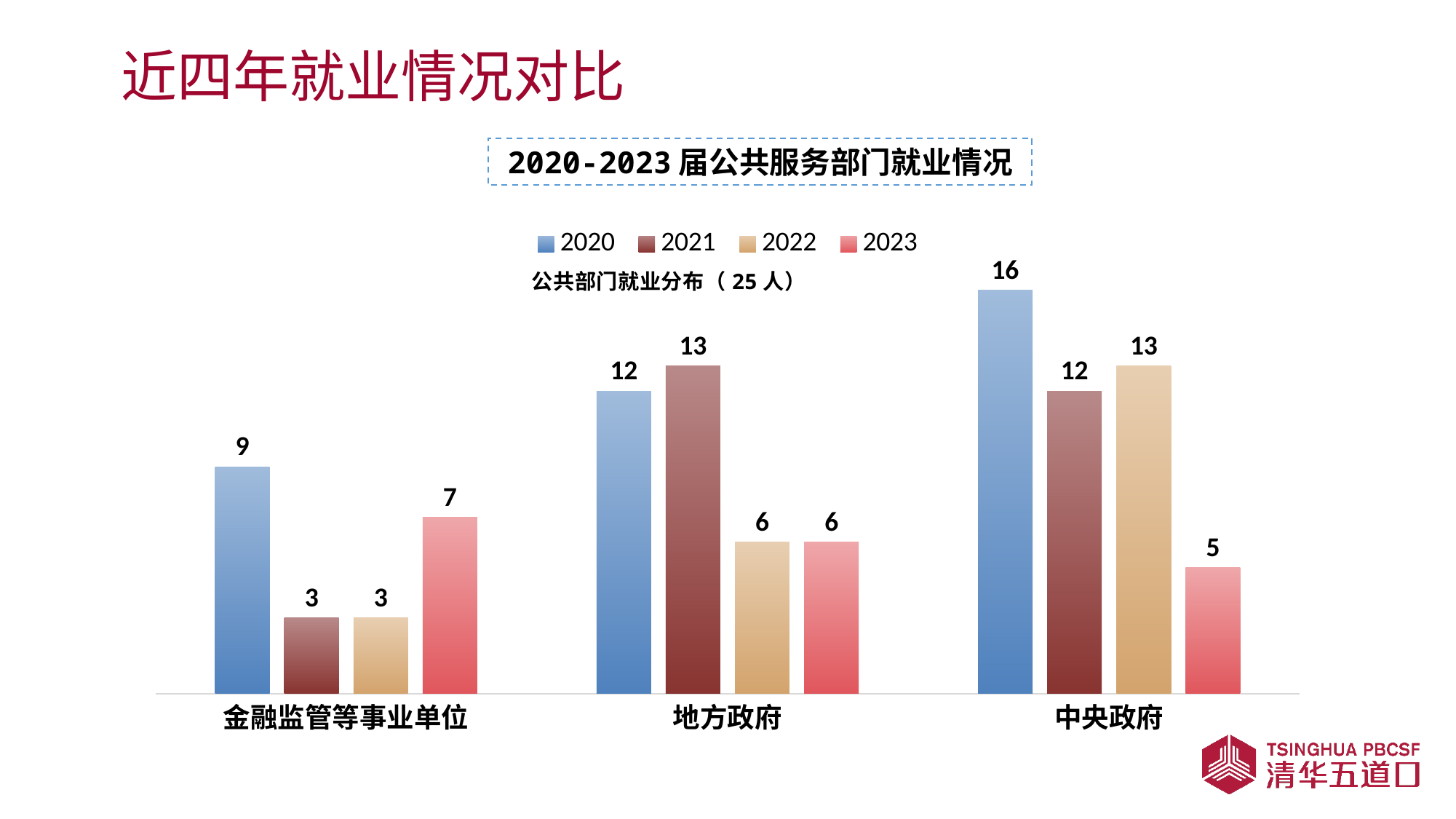
Which category has the lowest value for the 2023 series? 中央政府 What is the difference between the 2020 and 2023 values for 中央政府? 11 What is the value for 2020 in the 中央政府 category? 16 What is the title of the chart? 2020-2023 届公共服务部门就业情况 What kind of chart is shown on the slide? Bar chart What is the value for 2023 in the 金融监管等事业单位 category? 7 Which category has the highest value for the 2020 series? 中央政府 Which is larger for 地方政府: the 2020 value or the 2021 value? 2021 What is the total of the 2022 values across all three categories? 22 What is the value for 2021 in the 地方政府 category? 13 How many series does the legend list? 4 How many categories are shown on the x axis? 3